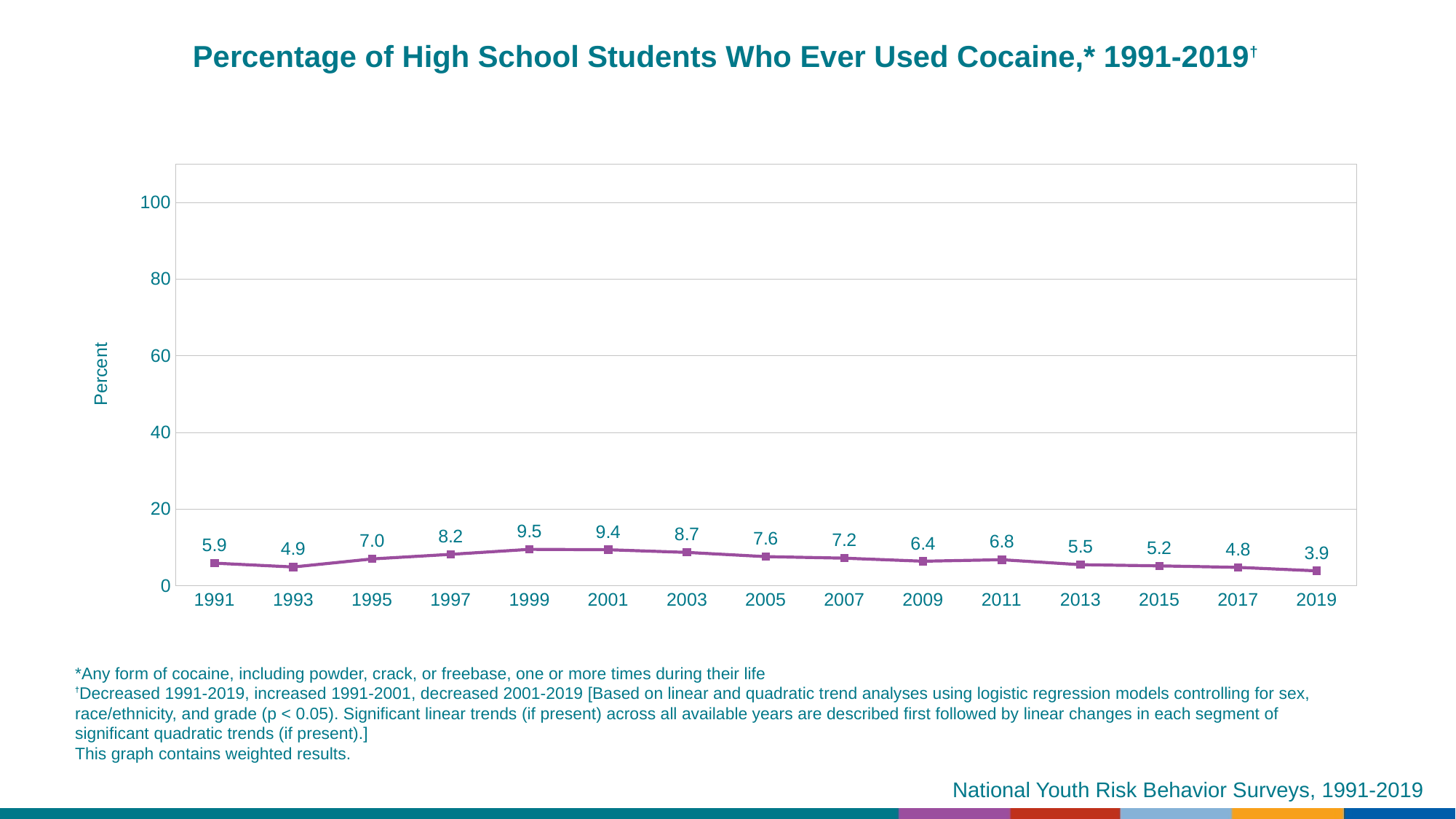
Is the value for 2001 greater or less than 20? less What kind of chart is shown on the slide? line chart What is the difference between the values for 1999 and 2019? 5.6 Which year has the highest percentage? 1999 Which year has the lowest percentage? 2019 What is the label of the y axis? Percent Which year has a larger value, 2003 or 2011? 2003 What is the value shown for 1991? 5.9 What is the value shown for 2019? 3.9 Do the values rise or fall from 2001 to 2019? fall What percentage of high school students had ever used cocaine in 1999? 9.5 How many years are plotted on the x axis? 15